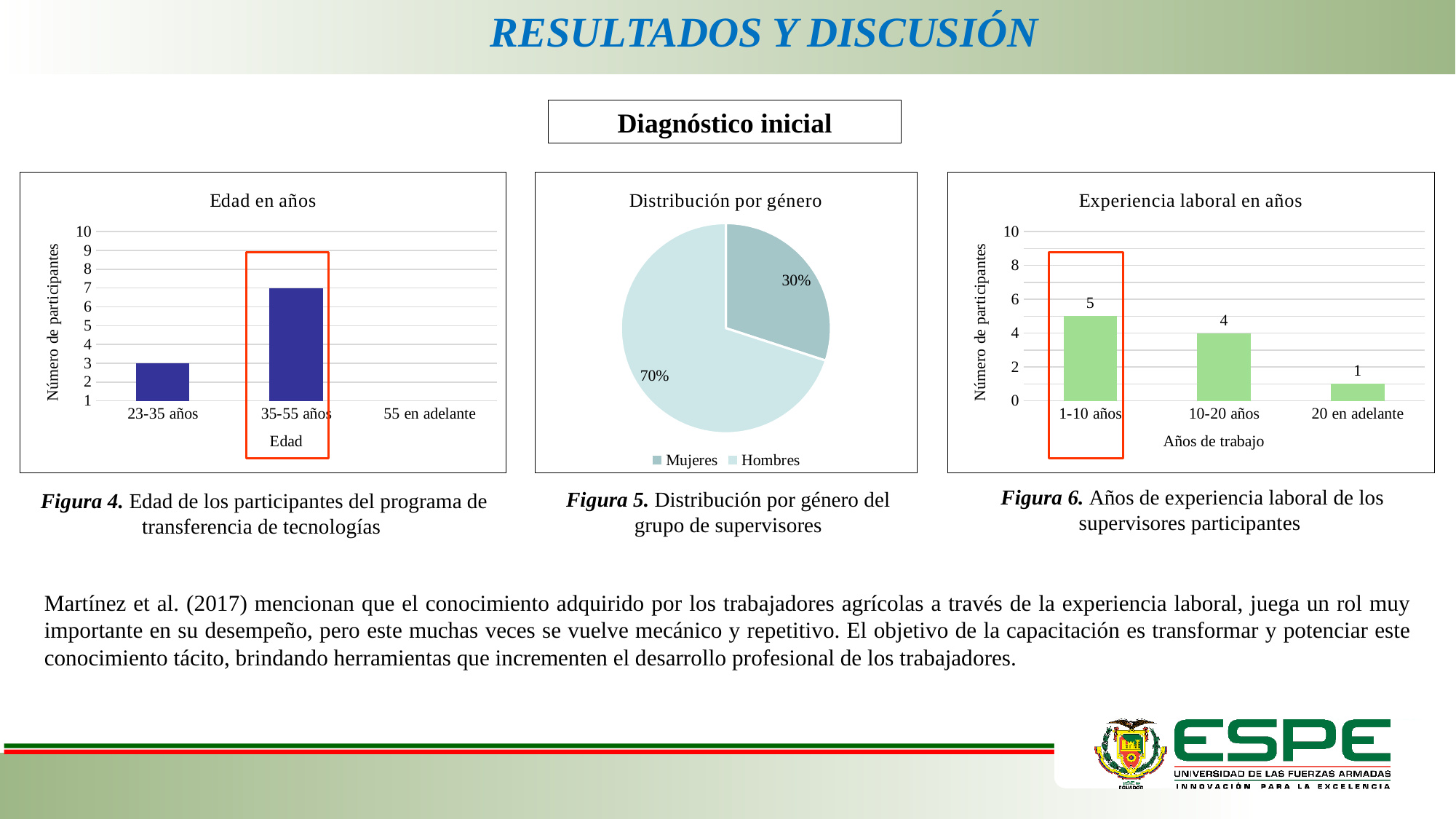
In the 'Edad en años' chart, which age category has the highest number of participants? 35-55 años In the 'Distribución por género' chart, what share of the pie is Hombres? 70% In the 'Edad en años' chart, is the value for 35-55 años greater or less than 5? greater In the 'Experiencia laboral en años' chart, what is the difference between the values for 1-10 años and 20 en adelante? 4 In the 'Distribución por género' chart, what share of the pie is Mujeres? 30% In the 'Experiencia laboral en años' chart, which category has the lowest number of participants? 20 en adelante In the 'Distribución por género' chart, how many entries does the legend list? 2 In the 'Edad en años' chart, is the value for 23-35 años greater or less than 5? less In the 'Experiencia laboral en años' chart, do the values rise or fall from left to right along the x axis? fall In the 'Edad en años' chart, what kind of chart is shown? bar chart In the 'Experiencia laboral en años' chart, what is the value for 10-20 años? 4 In the 'Edad en años' chart, how many age categories are shown on the x axis? 3